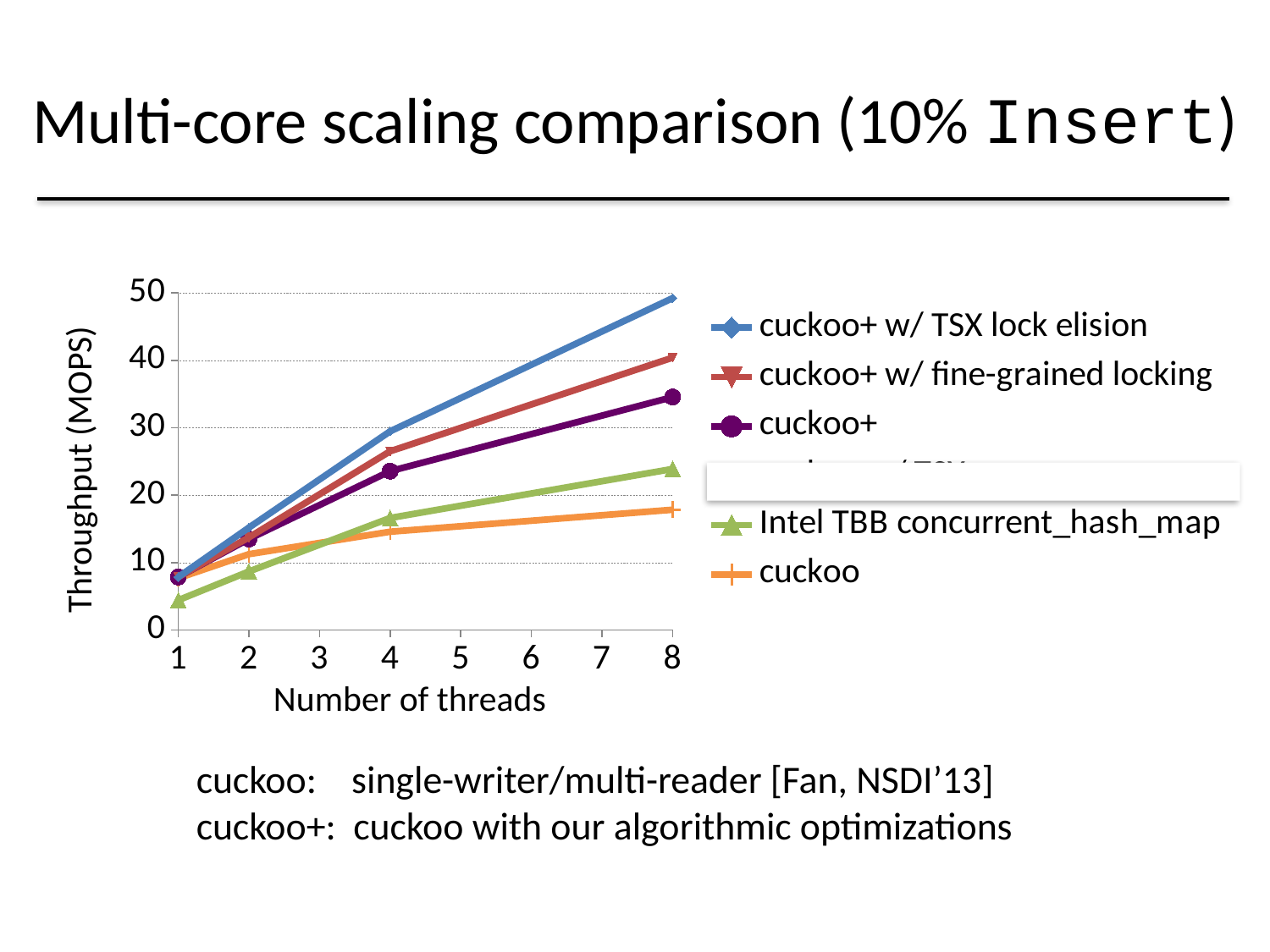
What is the label of the y axis? Throughput (MOPS) Is the throughput of cuckoo+ at 8 threads greater or less than 30 MOPS? greater Does the throughput of cuckoo+ w/ TSX lock elision rise or fall as the number of threads increases? rises Which series has the lowest throughput at 8 threads? cuckoo At 8 threads, which has higher throughput: cuckoo+ or Intel TBB concurrent_hash_map? cuckoo+ Is the throughput of cuckoo+ w/ TSX lock elision at 8 threads greater or less than 40 MOPS? greater What is the label of the x axis? Number of threads Which series has the highest throughput at 8 threads? cuckoo+ w/ TSX lock elision Which series has the lowest throughput at 1 thread? Intel TBB concurrent_hash_map Is the throughput of cuckoo at 8 threads greater or less than 20 MOPS? less What kind of chart is shown on the slide? line chart